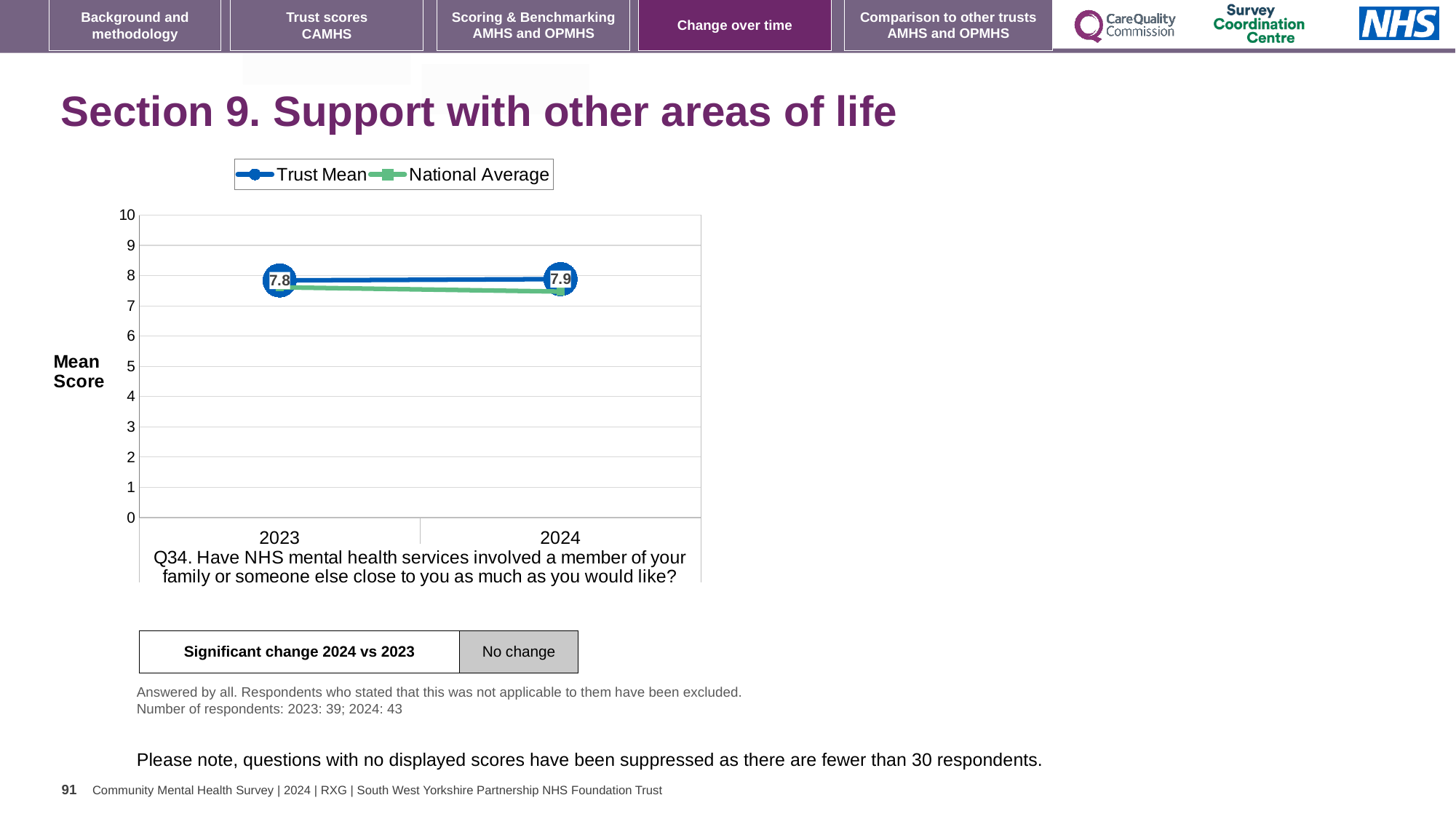
What is the Trust Mean value for 2024? 7.9 How many series does the legend list? 2 What are the two series named in the chart legend? Trust Mean and National Average What is the Trust Mean value for 2023? 7.8 What kind of chart is shown on the slide? line chart Does the Trust Mean rise or fall from 2023 to 2024? rise Is the National Average value for 2023 greater or less than 5? greater By how much did the Trust Mean change from 2023 to 2024? 0.1 How many years are shown on the x axis of the chart? 2 Which year has the higher Trust Mean, 2023 or 2024? 2024 In 2024, which is higher, the Trust Mean or the National Average? Trust Mean What is the label on the y axis of the chart? Mean Score